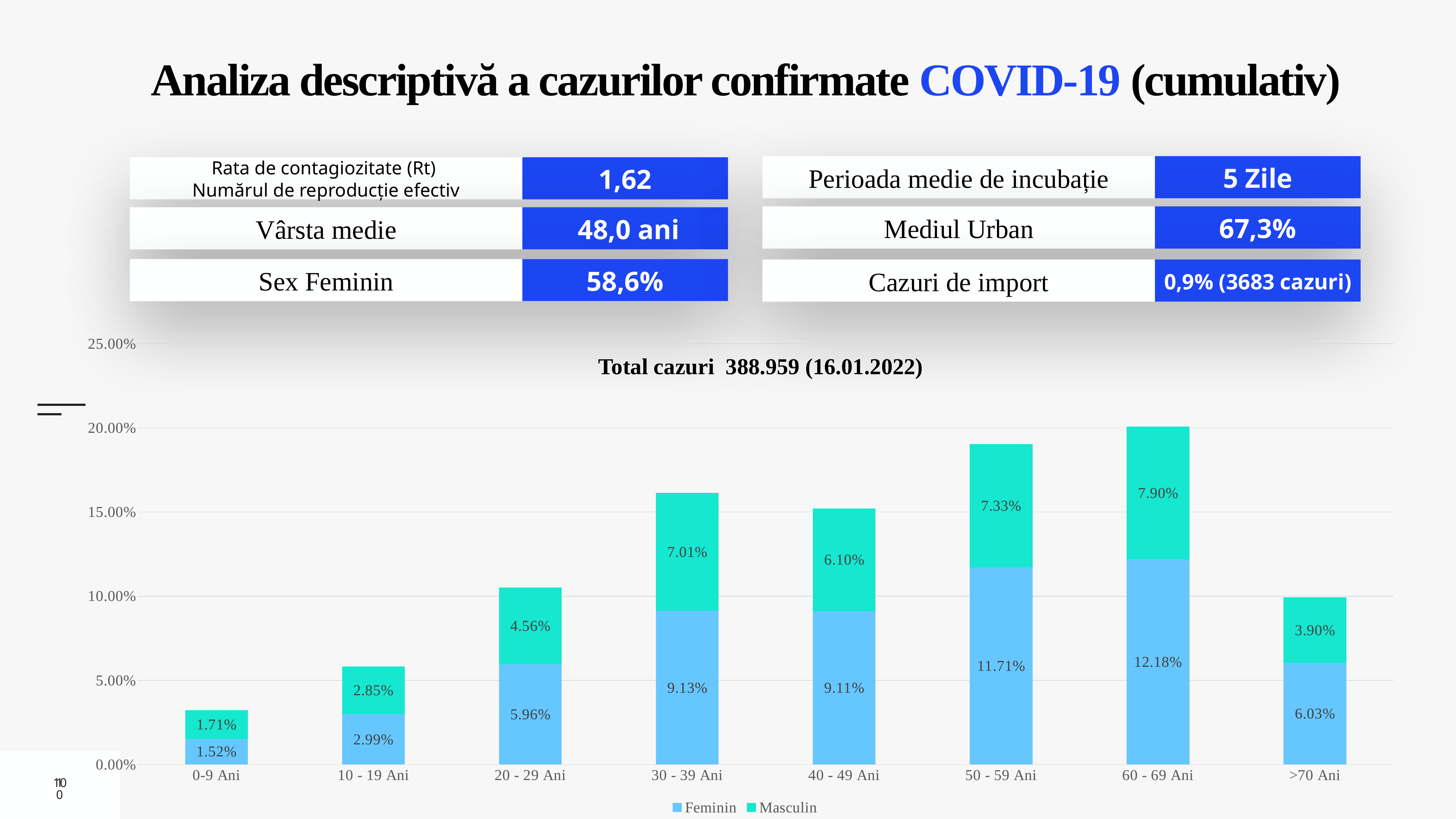
What is the total of the stacked bar for the 10 - 19 Ani age group? 5.84% What is the difference between the Feminin and Masculin values for the 60 - 69 Ani age group? 4.28% Which age group has the highest Feminin value? 60 - 69 Ani How many age groups are shown on the x axis of the chart? 8 What is the Masculin value for the 20 - 29 Ani age group? 4.56% Which age group has the lowest Masculin value? 0-9 Ani Which is larger, the Masculin value for 50 - 59 Ani or the Masculin value for 40 - 49 Ani? 50 - 59 Ani What is the Feminin value for the 30 - 39 Ani age group? 9.13% What is the total of the stacked bar for the 60 - 69 Ani age group? 20.08% How many series does the chart legend list? 2 What kind of chart is shown on the slide? Stacked bar chart What is the Masculin value for the >70 Ani age group? 3.90%